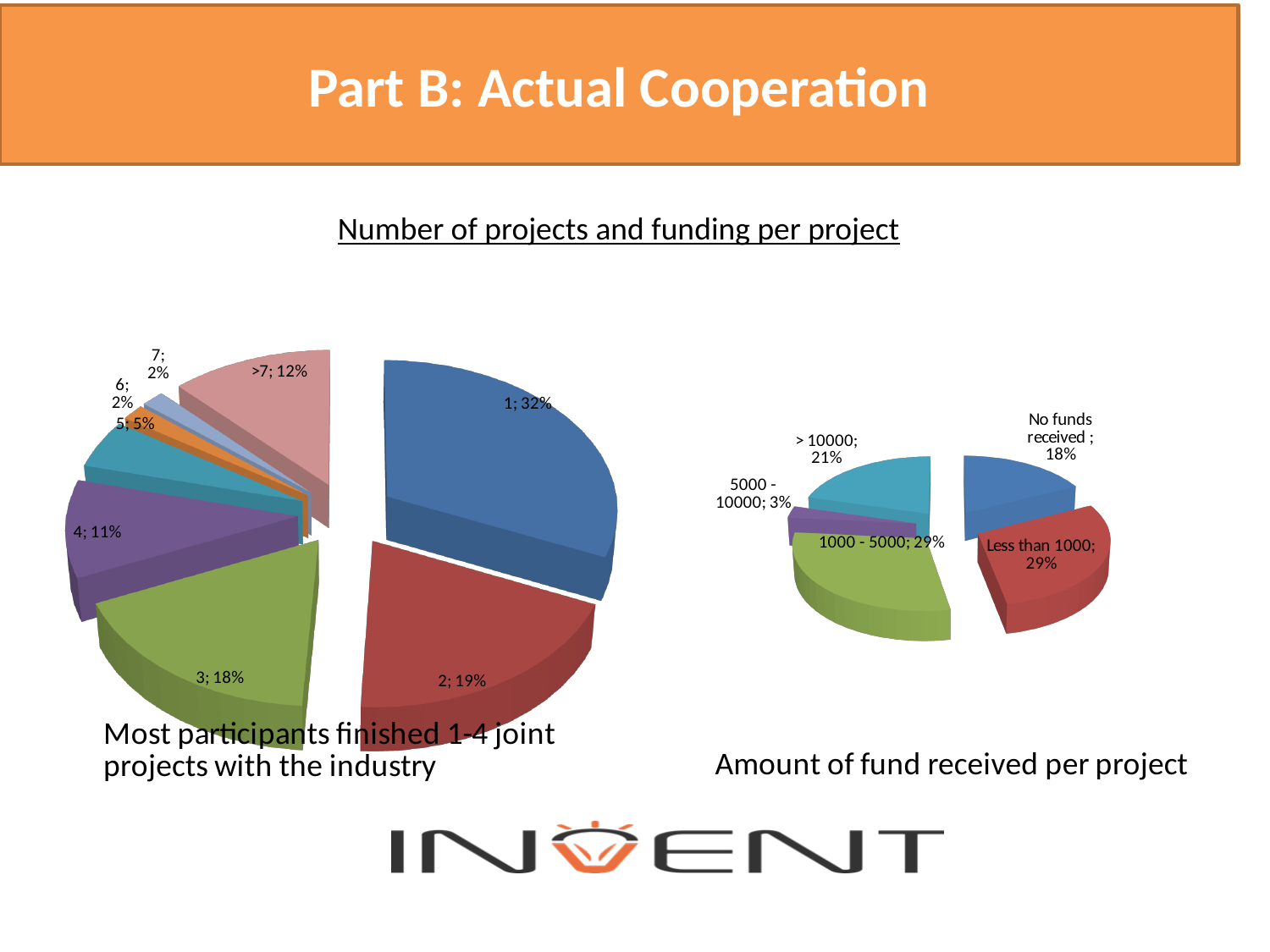
In the right pie chart (amount of fund received per project), which category has the smallest share? 5000 - 10000 In the left pie chart (number of projects), which is larger: the share for 4 projects or the share for >7 projects? >7 In the left pie chart (number of projects), what share of participants finished 3 projects? 18% In the right pie chart (amount of fund received per project), what share received no funds? 18% In the left pie chart (number of projects), what share of participants finished more than 7 projects? 12% In the right pie chart (amount of fund received per project), what share received 5000 - 10000? 3% In the left pie chart (number of projects), how many slices does the pie have? 8 In the right pie chart (amount of fund received per project), how many categories are shown? 5 What type of chart is used on the right side of the slide for amount of fund received per project? Pie chart In the left pie chart (number of projects), what share of participants finished 1 project? 32% In the left pie chart (number of projects), what is the difference in share between 2 projects and 4 projects? 8% In the left pie chart (number of projects), which category has the largest share? 1